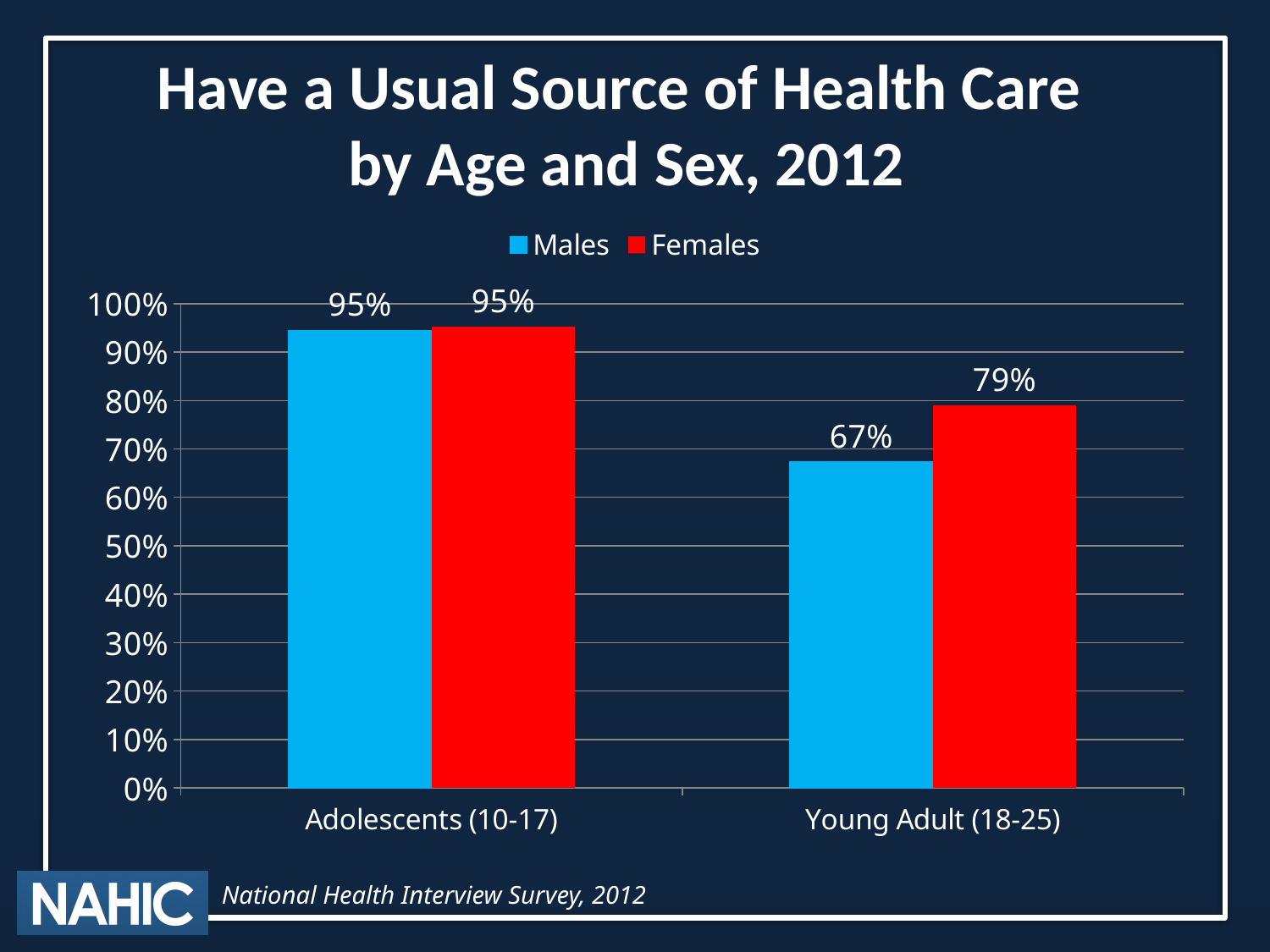
How many age groups are shown on the x axis? 2 Is the value for Males in the Young Adult (18-25) group greater or less than 70%? less In the Young Adult (18-25) group, which is larger, Males or Females? Females Which group and sex has the lowest percentage with a usual source of health care? Young Adult (18-25) Males What is the value for Males in the Young Adult (18-25) group? 67% How many series does the legend list? 2 What is the difference between Males in the Adolescents (10-17) group and Males in the Young Adult (18-25) group? 28% What is the difference between Females and Males in the Young Adult (18-25) group? 12% What is the value for Females in the Adolescents (10-17) group? 95% What kind of chart is shown on the slide? Bar chart What percentage of male adolescents (10-17) have a usual source of health care? 95% What percentage of female young adults (18-25) have a usual source of health care? 79%